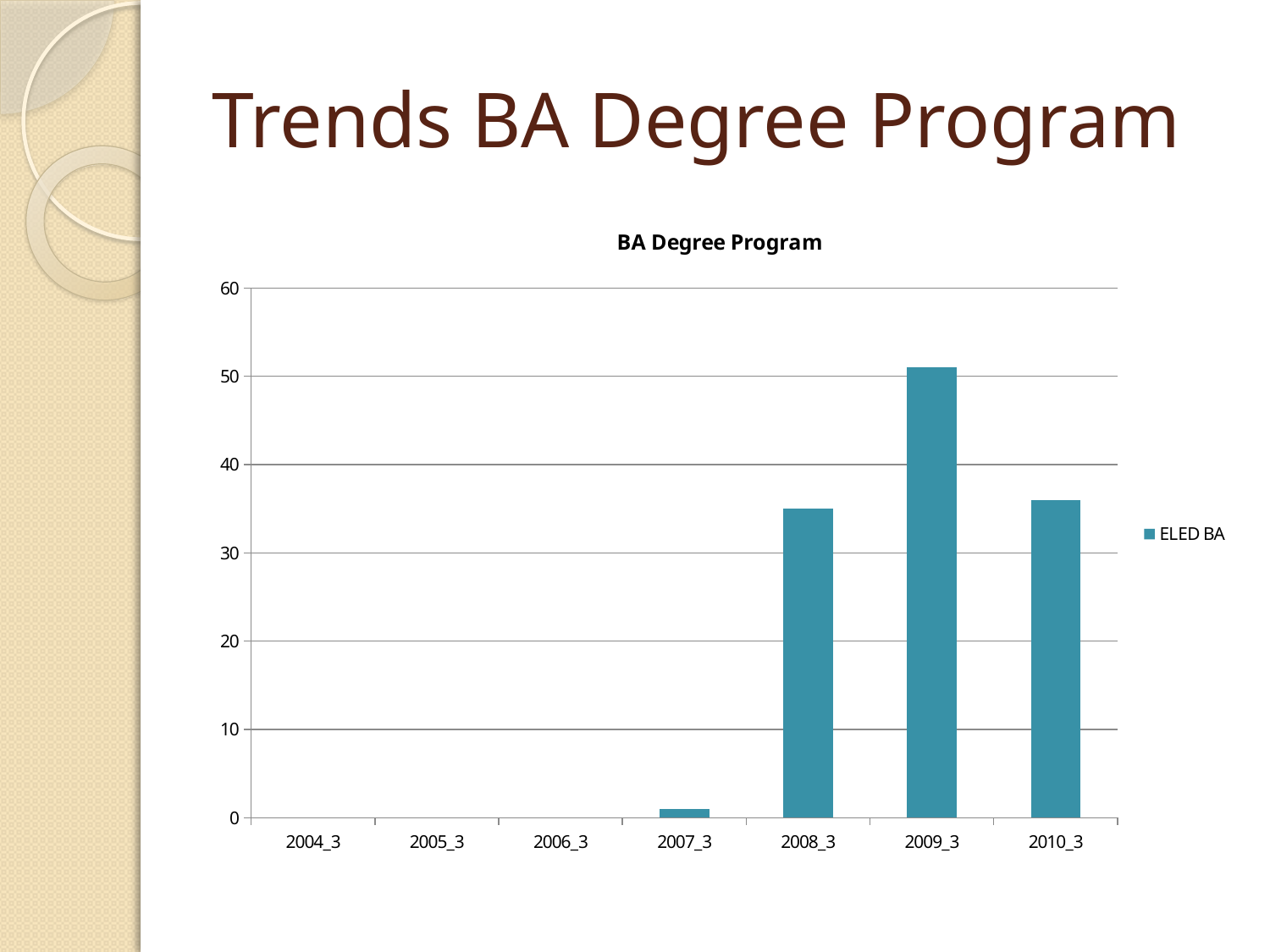
Is the value for 2007_3 greater or less than 10? less Do the values rise or fall from 2007_3 to 2009_3? rise How many series does the legend list? 1 Is the value for 2008_3 greater or less than 30? greater Which category has the highest value for ELED BA? 2009_3 What is the title of the chart? BA Degree Program What series name appears in the legend? ELED BA Is the value for 2009_3 greater or less than 50? greater What kind of chart is shown on the slide? bar chart Which is larger, the value for 2009_3 or the value for 2008_3? 2009_3 How many categories are shown on the x axis? 7